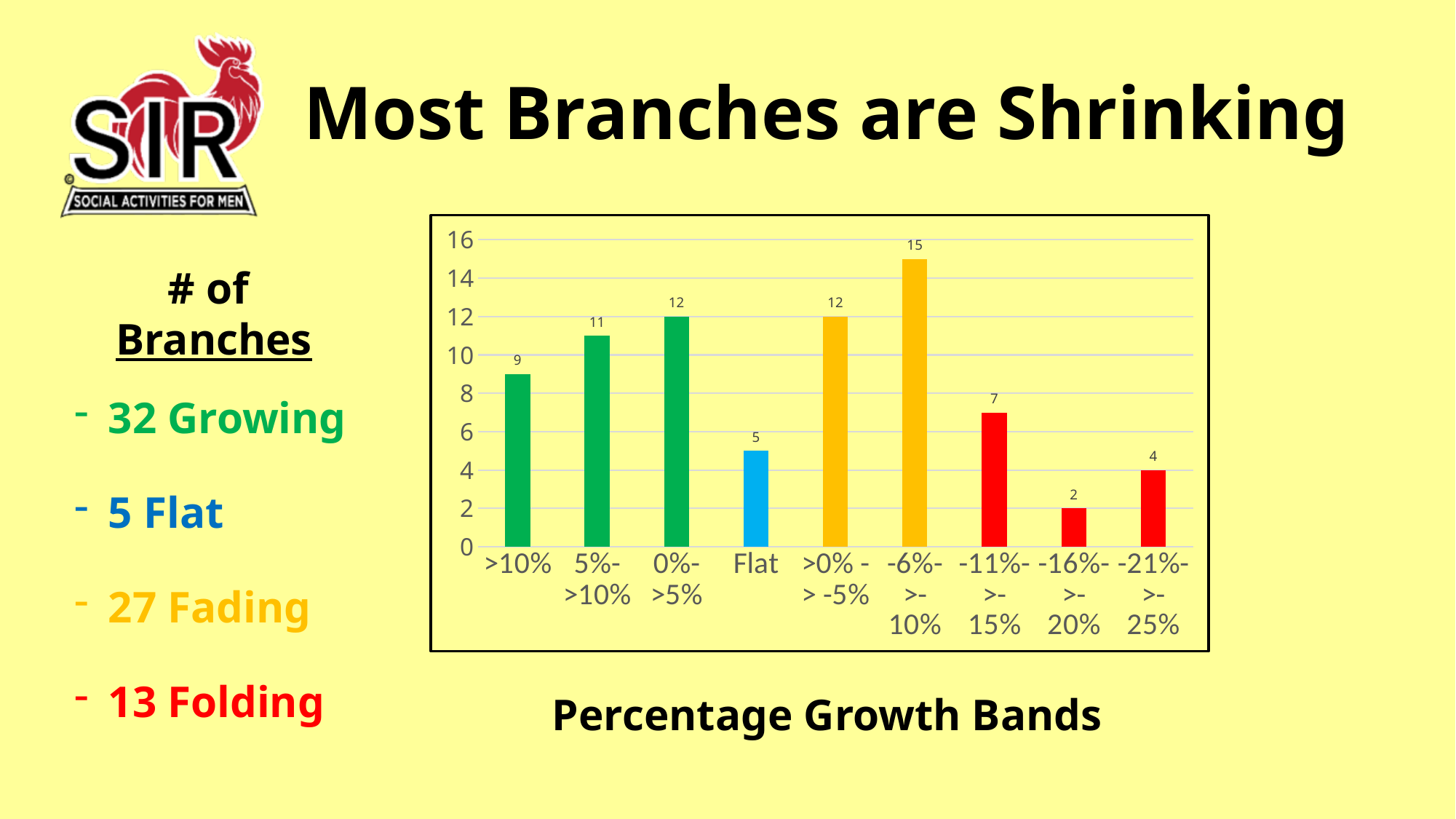
What is the number of branches in the "-16%->-20%" band? 2 Which has more branches, the "5%->10%" band or the "-21%->-25%" band? 5%->10% Which growth band has the lowest number of branches? -16%->-20% What colour is the bar for the "Flat" band? blue How many growth bands are shown on the x axis of the chart? 9 What is the number of branches in the "Flat" band? 5 What kind of chart is shown on the slide? bar chart What is the number of branches in the ">10%" growth band? 9 Which growth band has the highest number of branches? -6%->-10% What is the x-axis label shown below the chart? Percentage Growth Bands What is the difference between the number of branches in the "-6%->-10%" band and the "-11%->-15%" band? 8 What is the number of branches in the "-6%->-10%" band? 15